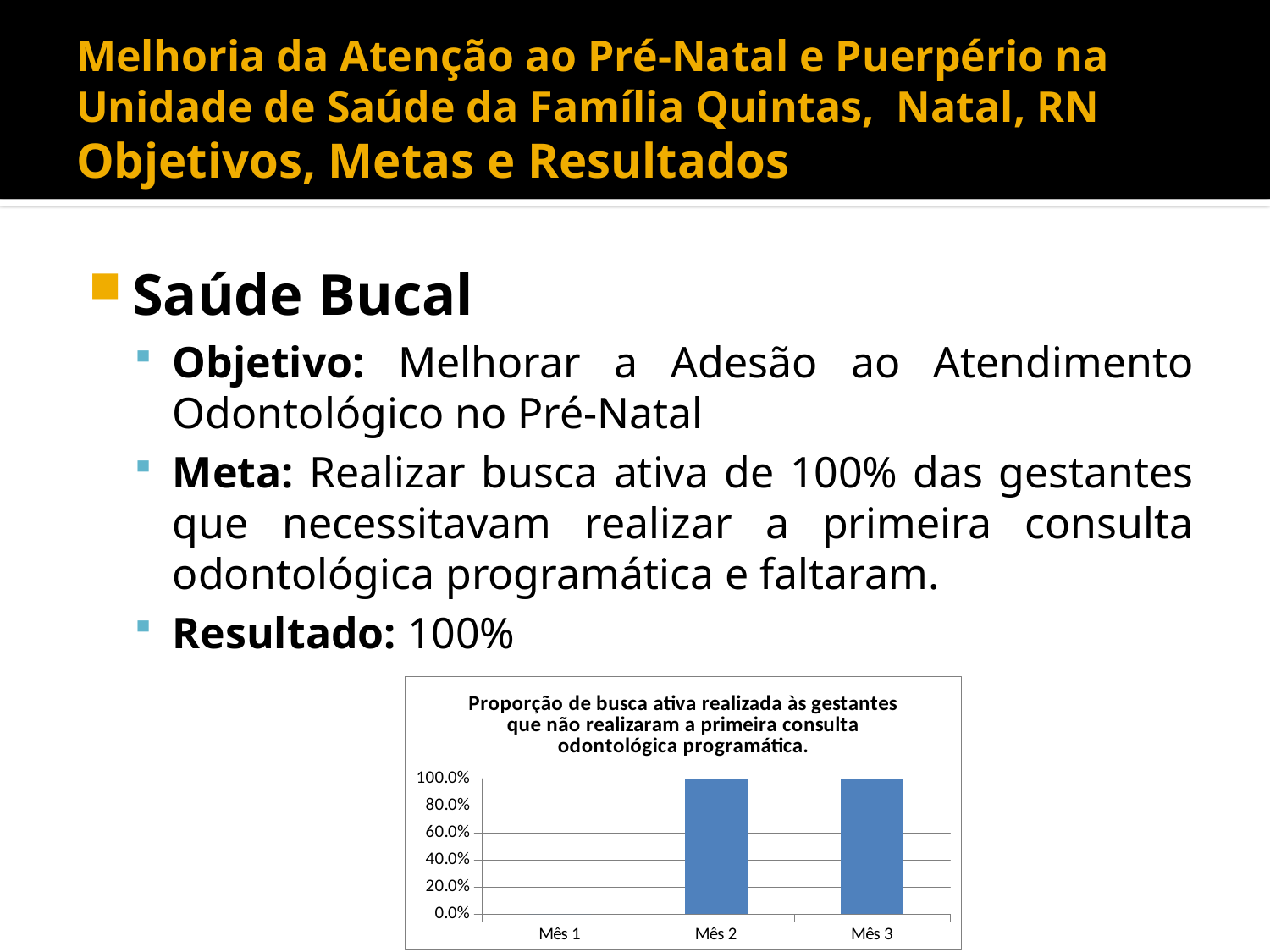
Do the values rise or fall from Mês 1 to Mês 3? rise What is the value for Mês 3 in the chart? 100.0% Which month has the lowest value in the chart? Mês 1 Which is larger, the value for Mês 1 or the value for Mês 2? Mês 2 Is the value for Mês 3 greater or less than 80.0%? greater What is the difference between the value for Mês 2 and the value for Mês 1? 100.0% What is the highest value shown on the y axis of the chart? 100.0% What kind of chart is shown on the slide? bar chart How many categories are shown on the x axis of the chart? 3 What is the value for Mês 2 in the chart? 100.0% What is the value for Mês 1 in the chart? 0.0% What is the title of the chart? Proporção de busca ativa realizada às gestantes que não realizaram a primeira consulta odontológica programática.